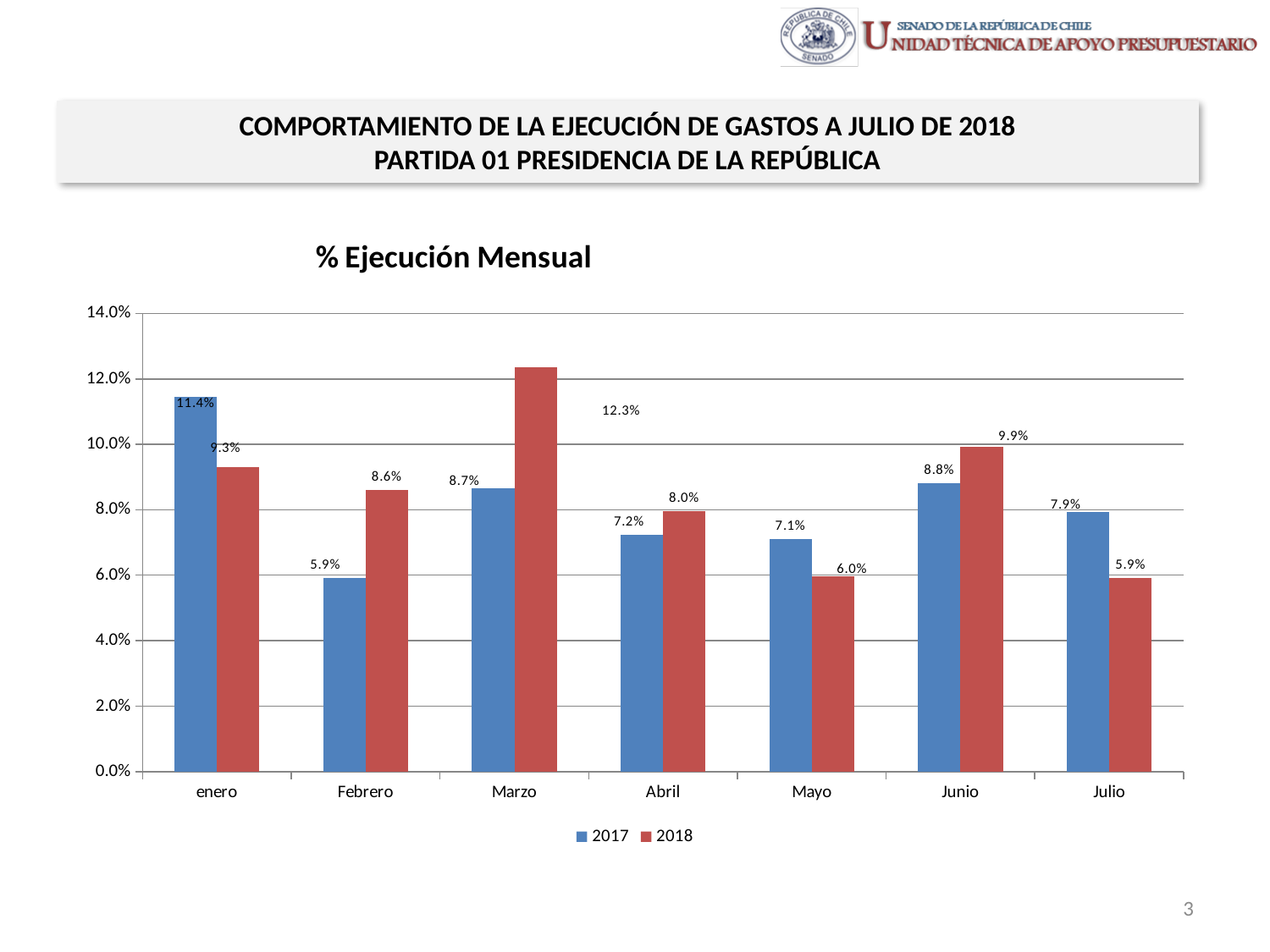
Which month has the lowest value for the 2017 series? Febrero Which month has the highest value for the 2017 series? enero In Junio, which series has the larger value, 2017 or 2018? 2018 What is the value for 2018 in Julio? 5.9% Is the value for 2018 in Marzo greater or less than 12.0%? greater How many series does the legend of the "% Ejecución Mensual" chart list? 2 What is the value for 2017 in enero? 11.4% Which month has the highest value for the 2018 series? Marzo How many months are shown on the x axis of the chart? 7 What is the value for 2018 in Febrero? 8.6% What is the difference between the 2017 and 2018 values in Mayo? 1.1 percentage points What kind of chart is shown on the slide? bar chart